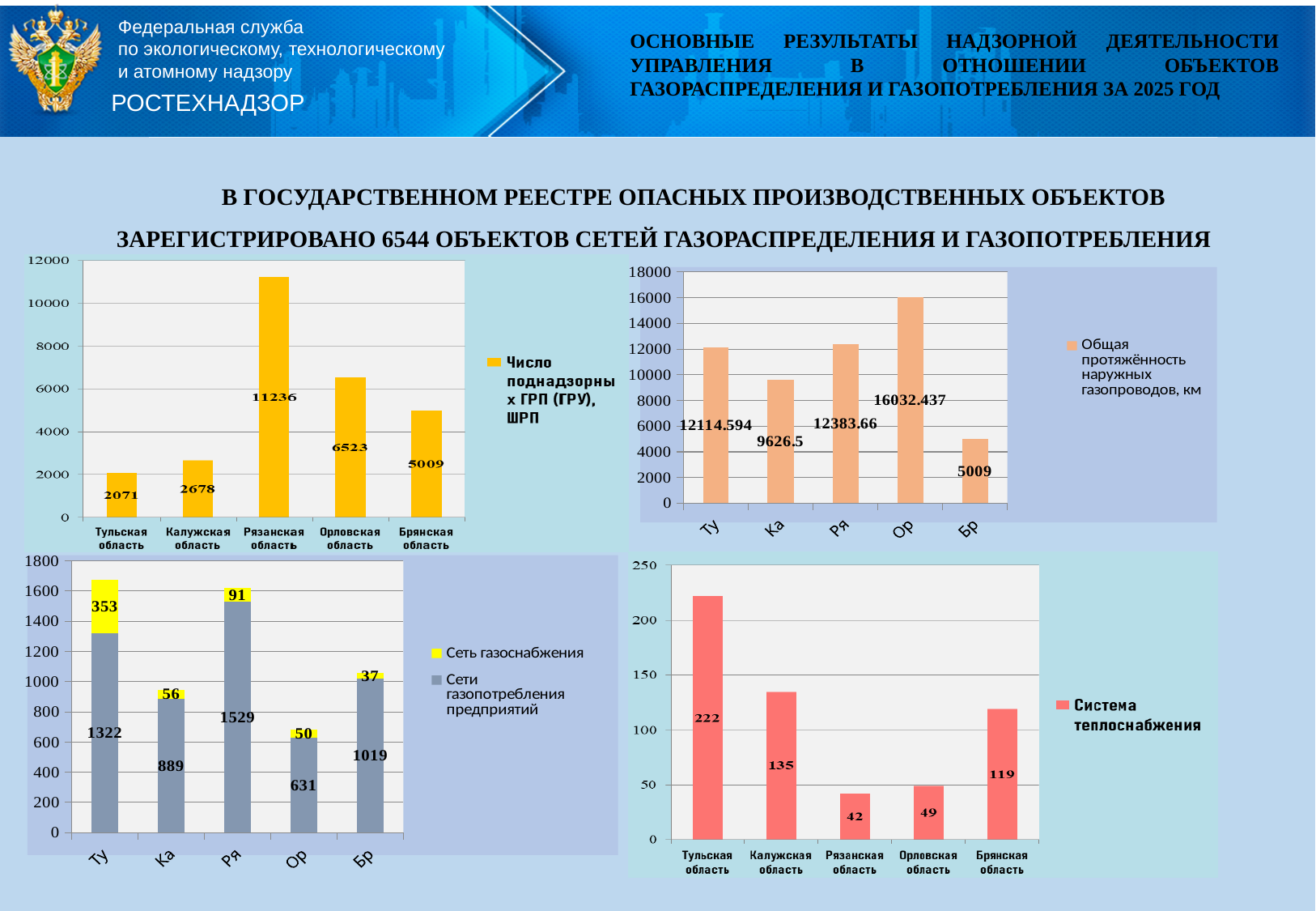
In the top-right chart (Общая протяжённость наружных газопроводов, км), which category has the highest value? Ор In the top-left chart (Число поднадзорных ГРП (ГРУ), ШРП), what is the value for Рязанская область? 11236 In the top-right chart (Общая протяжённость наружных газопроводов, км), what is the value for Ор? 16032.437 In the bottom-right chart (Система теплоснабжения), which region has the lowest value? Рязанская область In the bottom-left stacked chart, what is the total of the stacked bar for Ря? 1620 What kind of chart is the bottom-right chart (Система теплоснабжения)? Bar chart In the top-left chart (Число поднадзорных ГРП (ГРУ), ШРП), what is the difference between Орловская область and Брянская область? 1514 In the top-left chart (Число поднадзорных ГРП (ГРУ), ШРП), which region has the lowest value? Тульская область In the bottom-right chart (Система теплоснабжения), what is the value for Калужская область? 135 In the top-right chart (Общая протяжённость наружных газопроводов, км), which is larger: Ту or Ка? Ту In the bottom-left stacked chart, what is the value of Сеть газоснабжения for Ту? 353 How many series does the legend of the bottom-left stacked chart list? 2